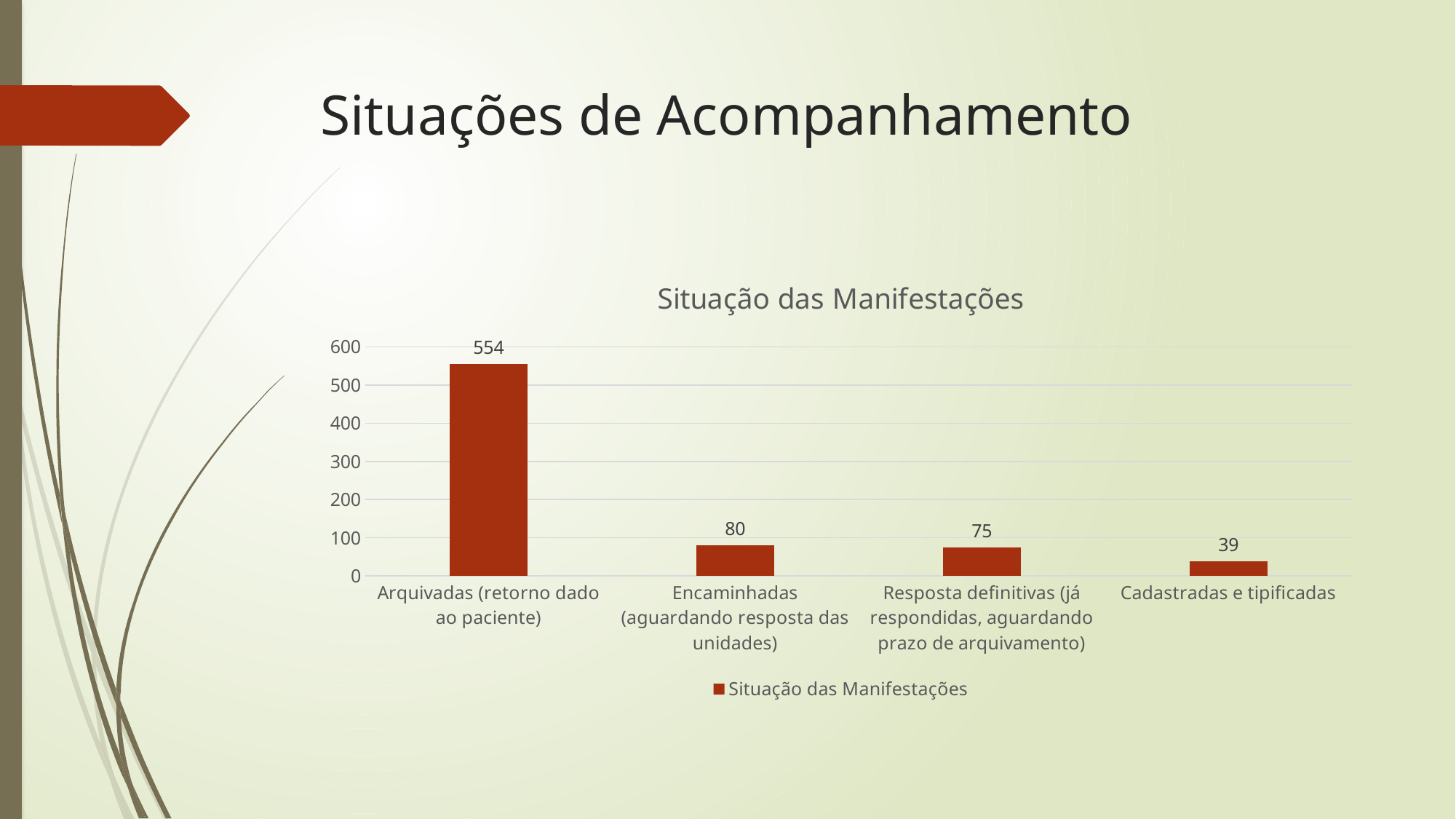
What is the value for Resposta definitivas (já respondidas, aguardando prazo de arquivamento)? 75 What is the title of the chart? Situação das Manifestações What is the value for Cadastradas e tipificadas? 39 What is the value for Arquivadas (retorno dado ao paciente)? 554 What is the difference between the values for Arquivadas (retorno dado ao paciente) and Encaminhadas (aguardando resposta das unidades)? 474 Which category has the lowest value? Cadastradas e tipificadas What is the value for Encaminhadas (aguardando resposta das unidades)? 80 What kind of chart is shown on the slide? Bar chart Which category has the highest value? Arquivadas (retorno dado ao paciente) How many categories are shown on the x axis? 4 What is the difference between the values for Resposta definitivas and Cadastradas e tipificadas? 36 Which is larger, the value for Encaminhadas or the value for Cadastradas e tipificadas? Encaminhadas